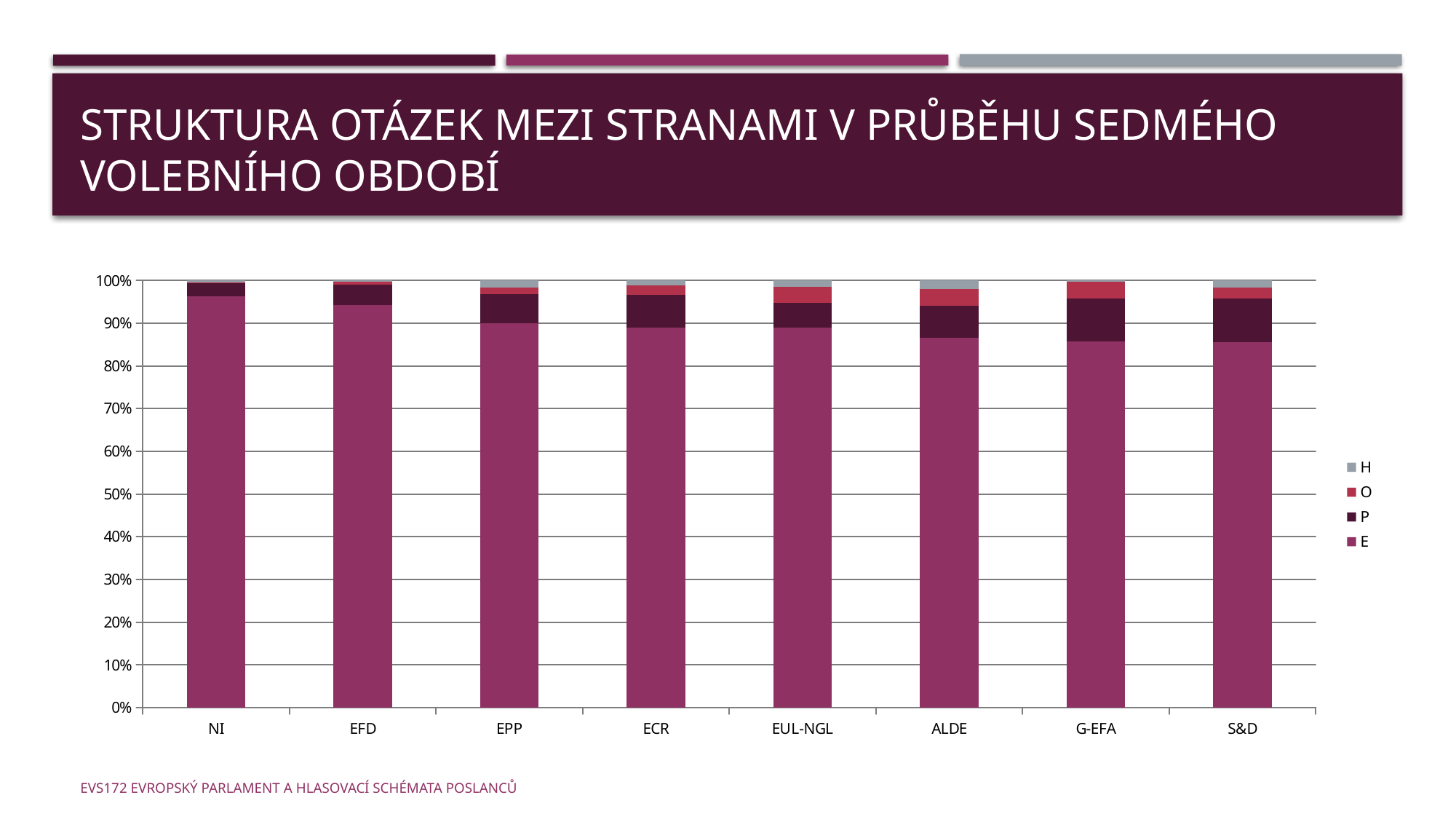
How many series does the legend list? 4 What is the total height of each stacked bar? 100% Is the value of the E segment for EFD greater or less than 90%? greater What kind of chart is shown on the slide? stacked bar chart Which is larger, the E segment for EFD or the E segment for G-EFA? EFD Is the value of the E segment for ALDE greater or less than 90%? less Is the value of the E segment for S&D greater or less than 90%? less How many categories (party groups) are shown on the x axis? 8 Which series are listed in the legend? H, O, P, E Which is larger, the E segment for NI or the E segment for S&D? NI Does the E segment generally rise or fall moving from NI on the left to S&D on the right? fall